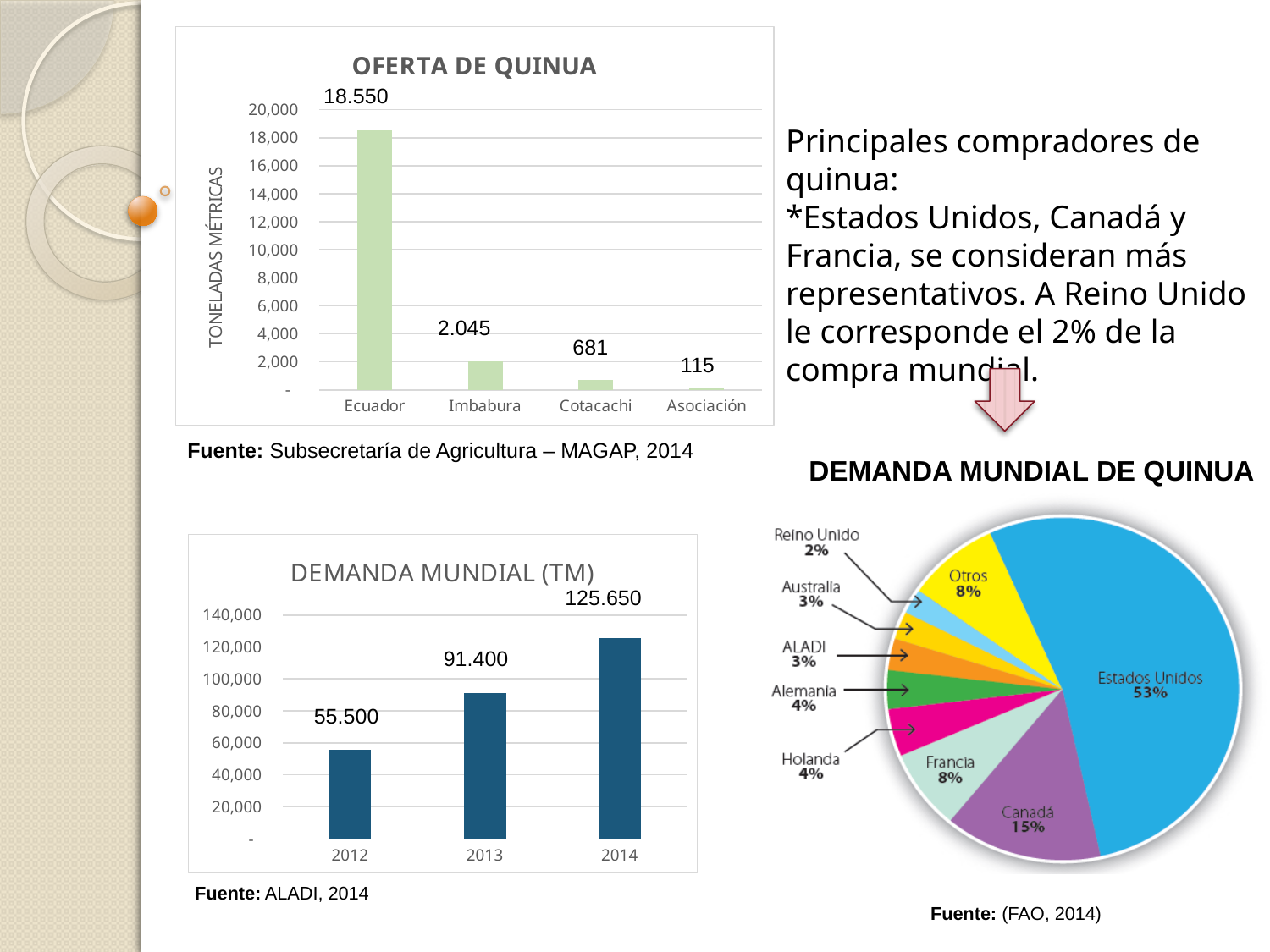
In the OFERTA DE QUINUA chart, what is the value for Cotacachi? 681 In the DEMANDA MUNDIAL (TM) chart, do the values rise or fall from 2012 to 2014? rise In the DEMANDA MUNDIAL DE QUINUA pie chart, which is larger, Francia or Alemania? Francia In the DEMANDA MUNDIAL (TM) chart, what is the difference between 2013 and 2012? 35.900 In the OFERTA DE QUINUA chart, which category has the lowest value? Asociación In the DEMANDA MUNDIAL DE QUINUA pie chart, which country has the largest slice? Estados Unidos What kind of chart is DEMANDA MUNDIAL (TM)? bar chart In the DEMANDA MUNDIAL (TM) chart, what is the value for 2013? 91.400 In the OFERTA DE QUINUA chart, what is the difference between Cotacachi and Asociación? 566 In the DEMANDA MUNDIAL DE QUINUA pie chart, what share does Canadá have? 15% In the OFERTA DE QUINUA chart, how many categories are shown on the x axis? 4 In the OFERTA DE QUINUA chart, what is the value for Ecuador? 18.550